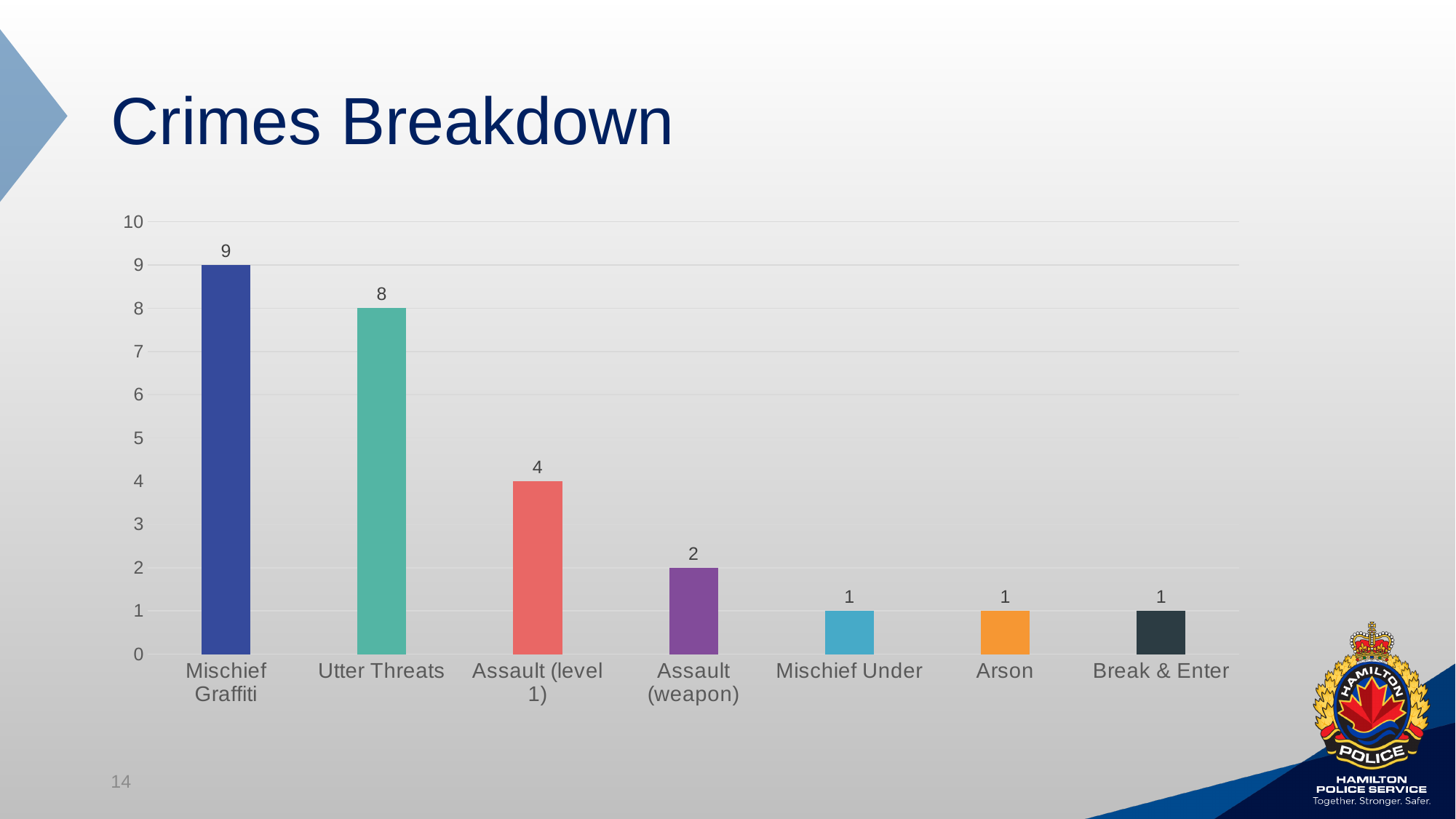
What is the difference between the values for Utter Threats and Assault (level 1)? 4 What is the value for Arson? 1 What is the value for Utter Threats? 8 Which category has the highest value? Mischief Graffiti What is the difference between the values for Mischief Graffiti and Utter Threats? 1 How many categories are shown on the x axis? 7 Which is larger, the value for Assault (level 1) or the value for Assault (weapon)? Assault (level 1) What is the title of the slide? Crimes Breakdown What kind of chart is shown on the slide? Bar chart What is the value for Mischief Graffiti? 9 What is the value for Assault (level 1)? 4 What is the value for Assault (weapon)? 2